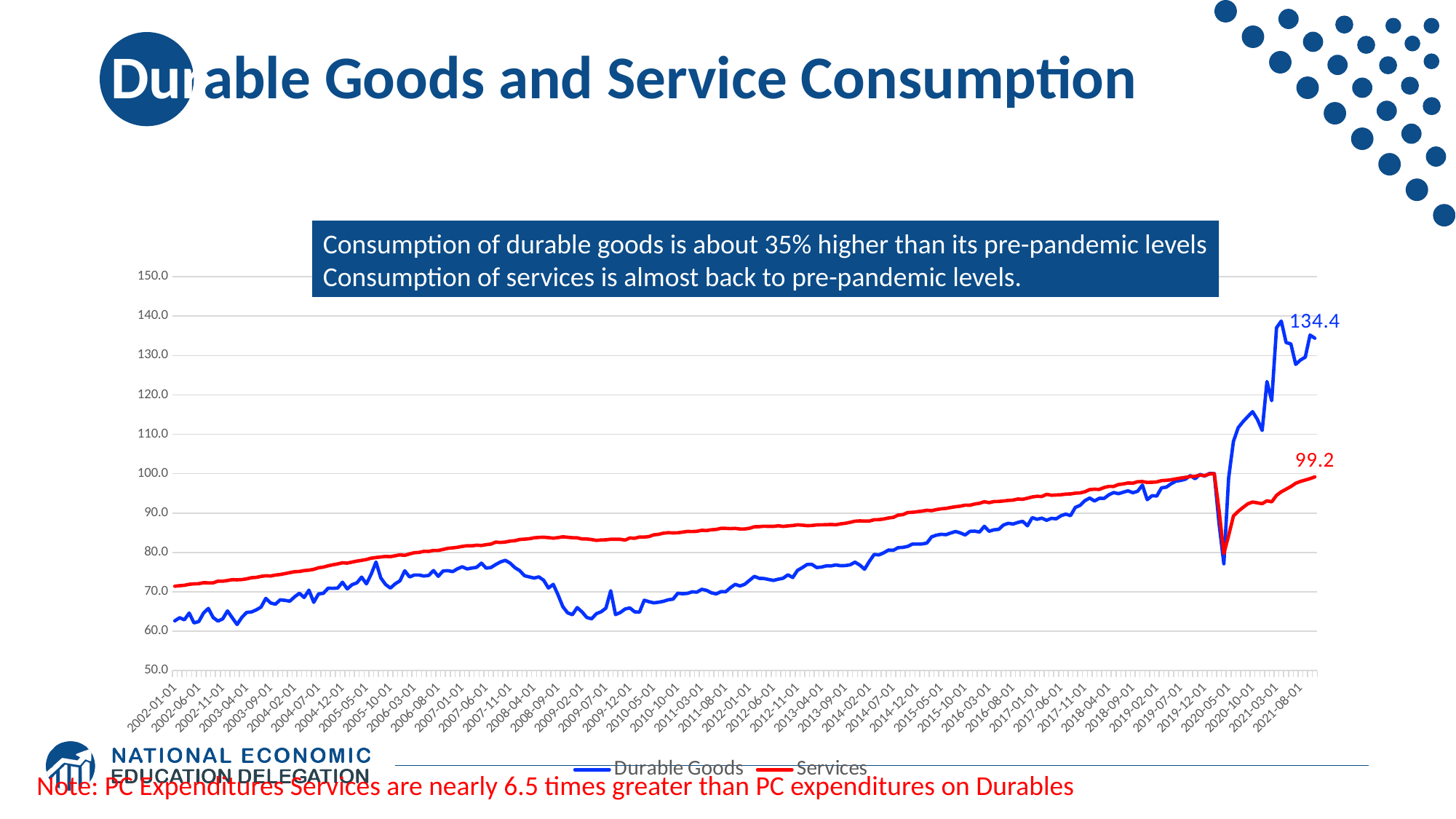
Which series reaches the highest value anywhere on the chart? Durable Goods What kind of chart is shown on the slide? line chart What is the difference between the final labelled values of Durable Goods (134.4) and Services (99.2)? 35.2 What is the final labelled value of the Durable Goods series? 134.4 What colour is the Services line in the chart? red At the end of the chart, which series has the higher value, Durable Goods or Services? Durable Goods Is the value for Services at 2002-01-01 greater or less than 80? less Is the value for Services at 2019-12-01 greater or less than 90? greater How many series does the chart legend list? 2 Is the value for Durable Goods at 2002-01-01 greater or less than 70? less Does the Services line generally rise or fall from 2002 to 2019? rise What is the final labelled value of the Services series? 99.2